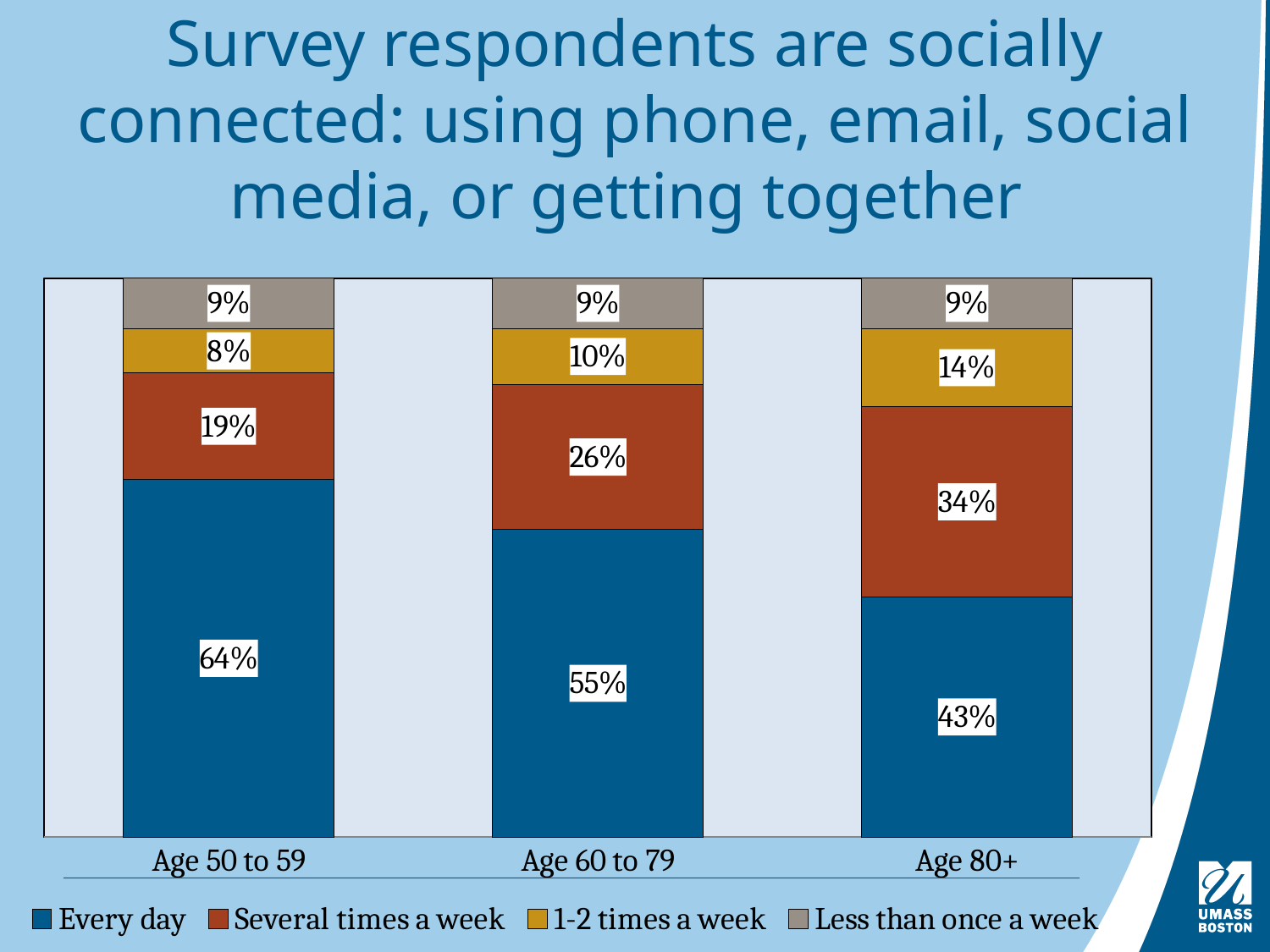
What kind of chart is shown on the slide? Stacked bar chart How many age groups are shown on the chart? 3 Which is larger: the 'Several times a week' share for Age 60 to 79 or for Age 50 to 59? Age 60 to 79 Which colour represents 'Less than once a week' in the legend? Gray What percentage of respondents aged 60 to 79 are socially connected 1-2 times a week? 10% Does the 'Every day' share rise or fall as age group increases from left to right? Fall What is the difference between the 'Every day' share for Age 50 to 59 and for Age 80+? 21 percentage points Which age group has the lowest share of respondents who are socially connected every day? Age 80+ What percentage of respondents aged 50 to 59 are socially connected every day? 64% How many series does the legend list? 4 Which age group has the highest share of respondents who are socially connected every day? Age 50 to 59 What percentage of respondents aged 80+ are socially connected several times a week? 34%